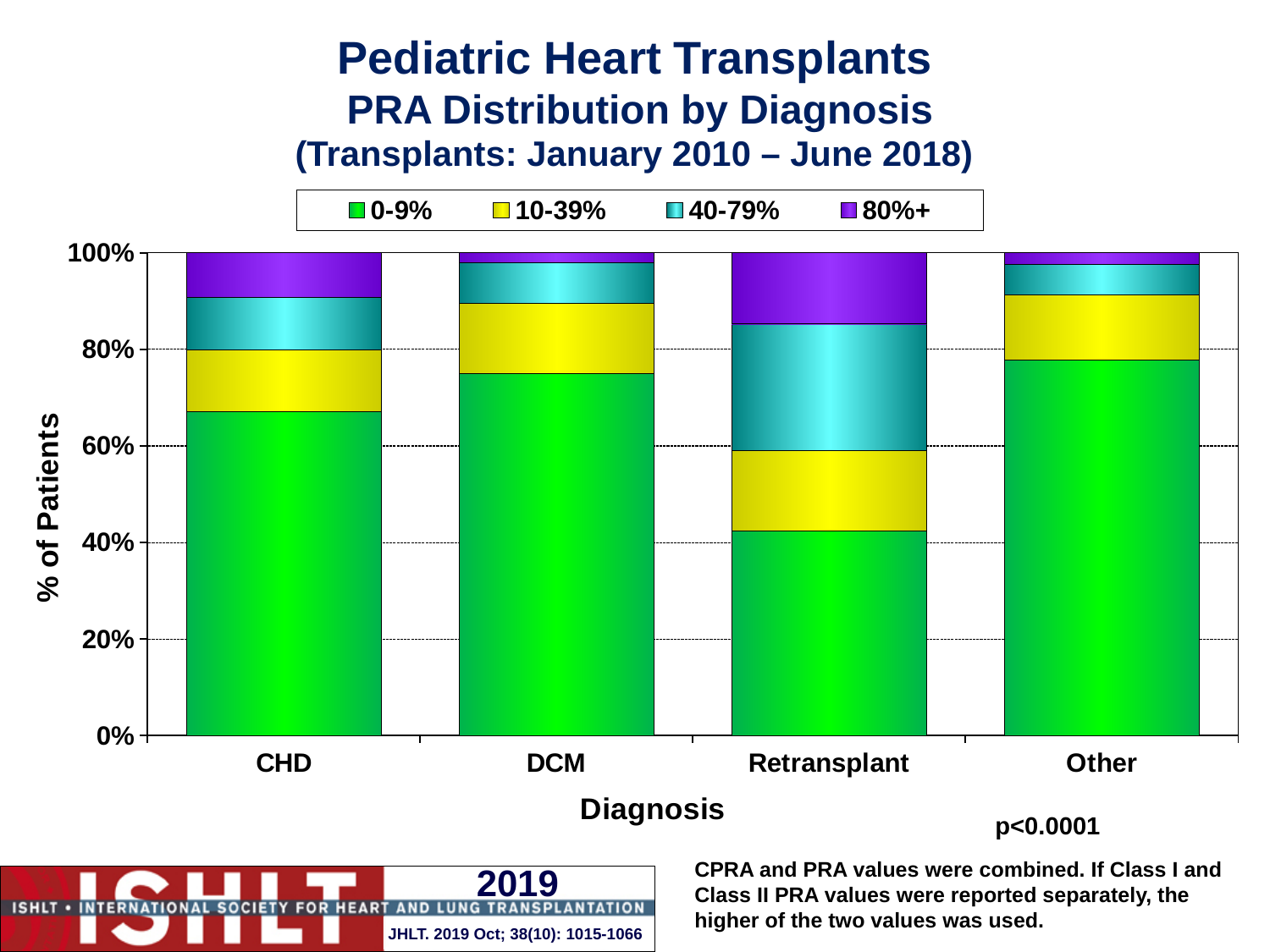
Is the 0-9% PRA share for Retransplant greater or less than 60%? less How many series does the legend list? 4 How many diagnosis categories are shown on the x axis? 4 What is the total height of each stacked bar? 100% Which diagnosis has the largest 80%+ PRA segment? Retransplant What kind of chart is shown on the slide? Stacked bar chart What is the label of the y axis? % of Patients Which diagnosis has the smallest 0-9% PRA segment? Retransplant Which diagnosis has the largest 40-79% PRA segment? Retransplant Which is larger, the 0-9% PRA share for DCM or for Retransplant? DCM Is the 0-9% PRA share for CHD greater or less than 60%? greater Is the 0-9% PRA share for DCM greater or less than 60%? greater